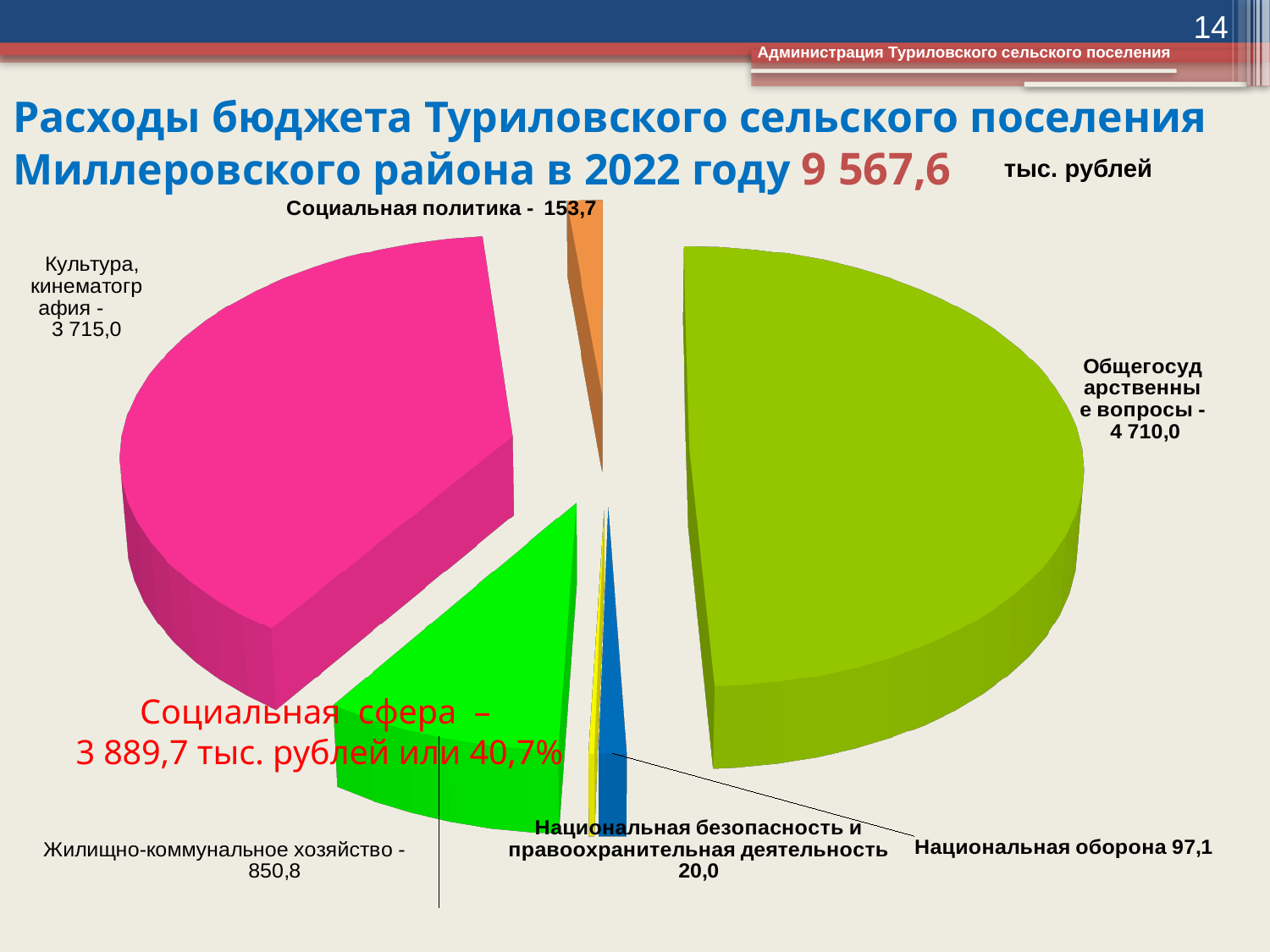
What is the value for Национальная безопасность и правоохранительная деятельность? 20,0 Which category has the largest slice of the pie? Общегосударственные вопросы What is the value for Культура, кинематография? 3 715,0 How many categories are shown in the pie chart? 6 What is the value for Общегосударственные вопросы? 4 710,0 Which category has the smallest slice of the pie? Национальная безопасность и правоохранительная деятельность What kind of chart is shown on the slide? pie chart What is the value for Жилищно-коммунальное хозяйство? 850,8 What is the difference between the values for Общегосударственные вопросы and Культура, кинематография? 995,0 Which is larger, the value for Жилищно-коммунальное хозяйство or the value for Социальная политика? Жилищно-коммунальное хозяйство What is the value for Национальная оборона? 97,1 What is the value for Социальная политика? 153,7